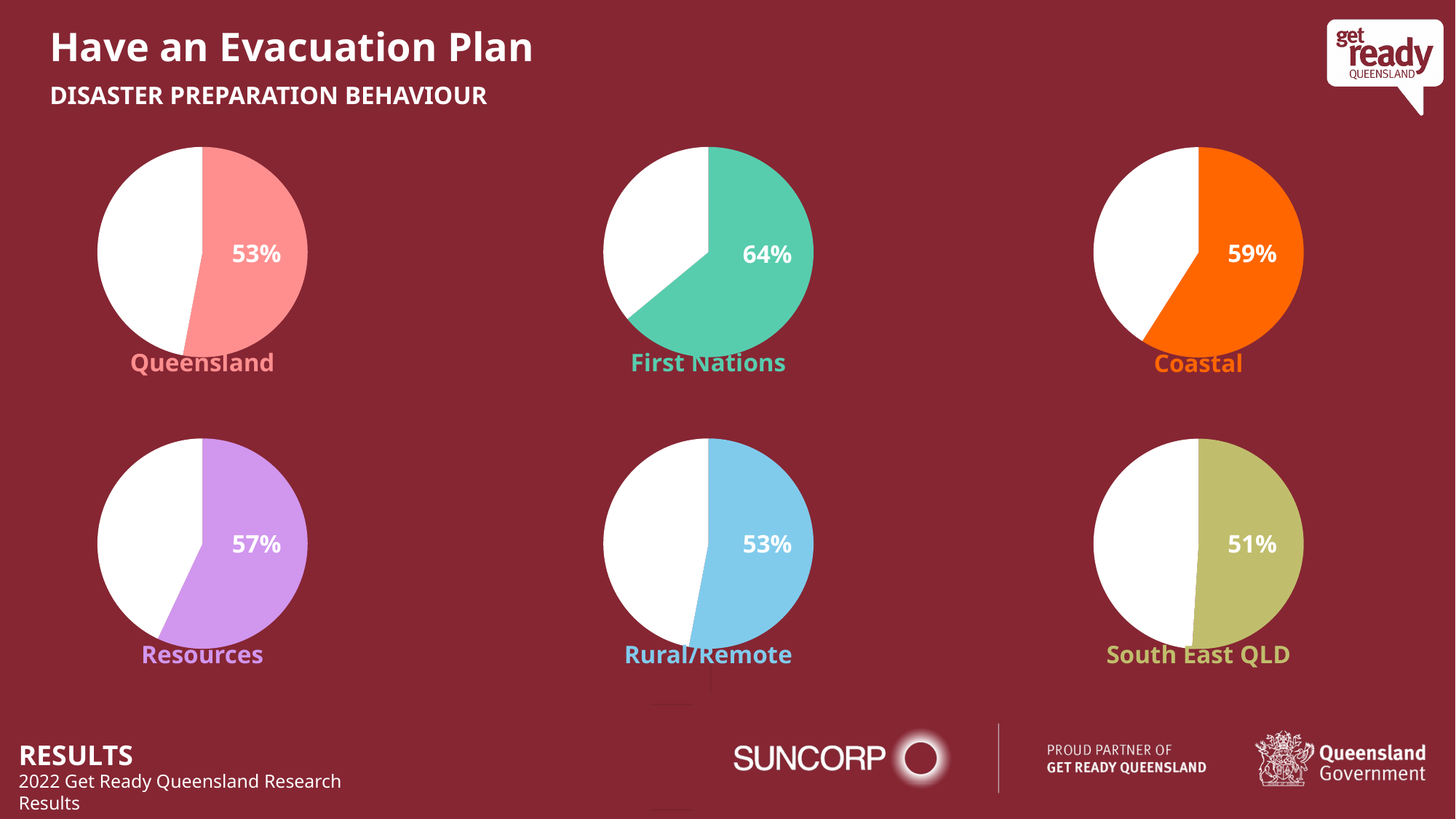
Across the six pie charts on the slide, which group has the lowest percentage with an evacuation plan? South East QLD Across the six pie charts on the slide, which group has the highest percentage with an evacuation plan? First Nations In the Resources pie chart, what percentage is shown for the coloured slice? 57% In the South East QLD pie chart, what percentage is shown for the coloured slice? 51% What type of chart is used for the Rural/Remote group on the slide? Pie chart In the Coastal pie chart, what percentage is shown for the coloured slice? 59% How many pie charts are shown on the slide? 6 Comparing the Coastal and Resources pie charts, which group has the larger percentage? Coastal In the Queensland pie chart, what percentage is shown for the coloured slice? 53% In the Coastal pie chart, what colour is the labelled slice? Orange In the First Nations pie chart, what percentage is shown for the coloured slice? 64% Comparing the First Nations and South East QLD pie charts, what is the difference between their percentages? 13 percentage points